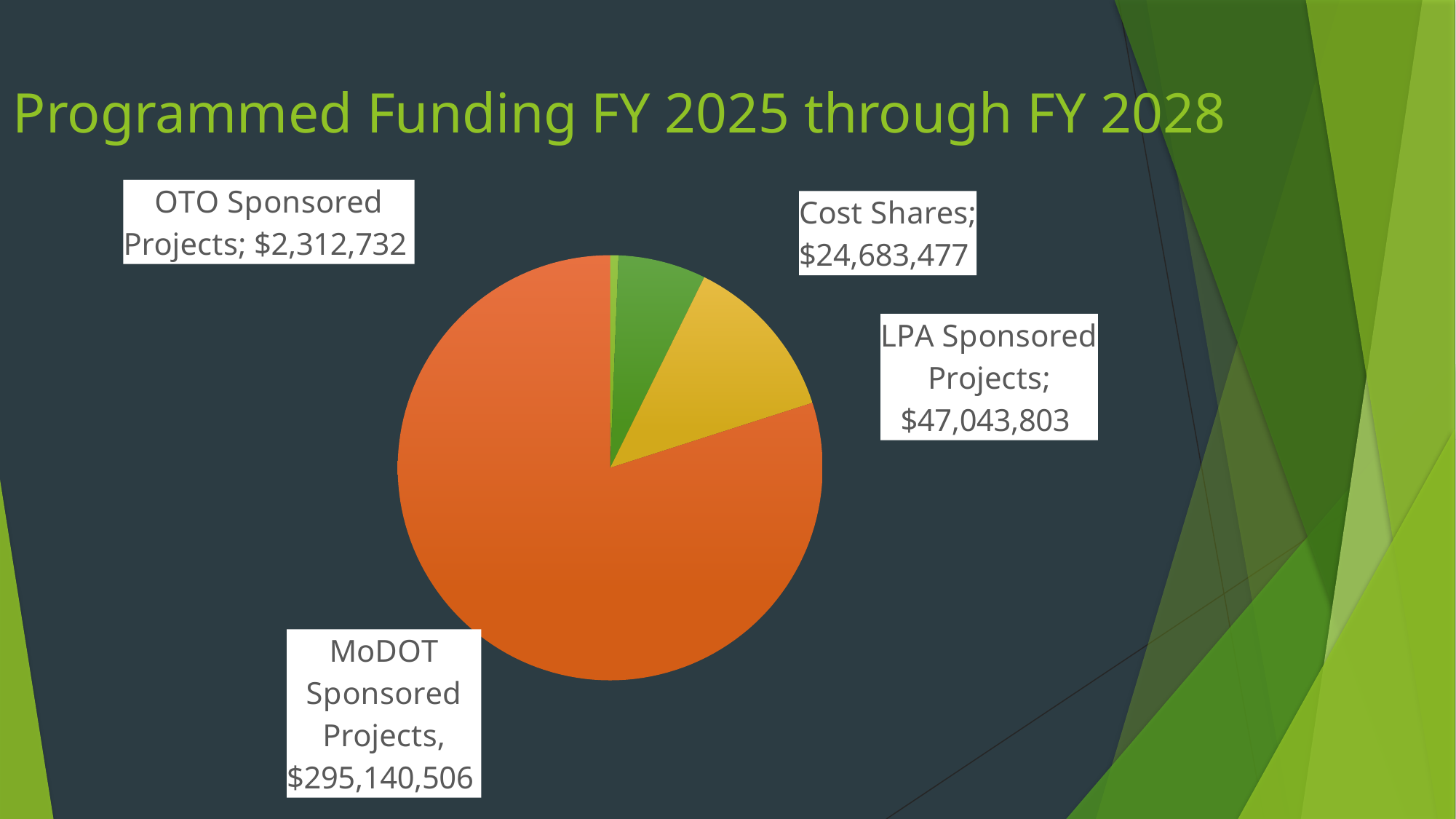
Which category has the largest share of programmed funding? MoDOT Sponsored Projects What is the total programmed funding across all four categories? $369,180,518 How many categories are shown in the pie chart? 4 What type of chart is shown on the slide? Pie chart Which is larger, the funding for LPA Sponsored Projects or for Cost Shares? LPA Sponsored Projects Which category has the smallest share of programmed funding? OTO Sponsored Projects What is the programmed funding amount for MoDOT Sponsored Projects? $295,140,506 What is the programmed funding amount for LPA Sponsored Projects? $47,043,803 What is the difference between the funding for LPA Sponsored Projects and Cost Shares? $22,360,326 What is the programmed funding amount for OTO Sponsored Projects? $2,312,732 What is the programmed funding amount for Cost Shares? $24,683,477 What is the title of the chart on the slide? Programmed Funding FY 2025 through FY 2028